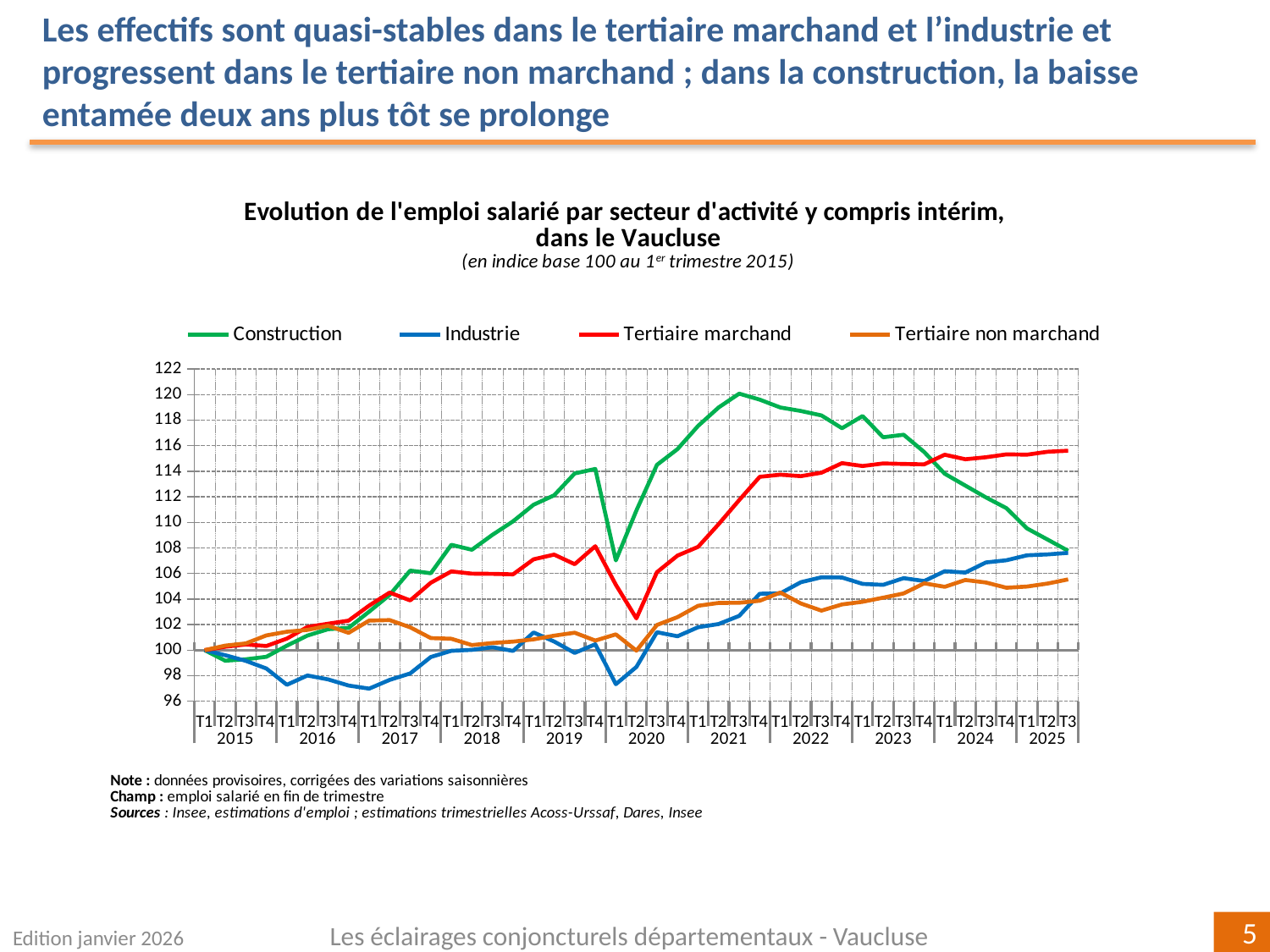
Which series is drawn in green? Construction Is the value for Industrie at T1 2020 greater or less than 100? less At T3 2025, which is higher: Construction or Tertiaire marchand? Tertiaire marchand Which series reaches the highest value anywhere on the chart? Construction Is the value for Tertiaire non marchand at T3 2025 greater or less than 104? greater Is the value for Tertiaire marchand at T3 2025 greater or less than 114? greater How many series does the legend list? 4 Does the Construction series rise or fall between T3 2021 and T3 2025? fall Which series reaches the lowest value anywhere on the chart? Industrie What kind of chart is shown on the slide? line chart What is the index value of all four series at T1 2015? 100